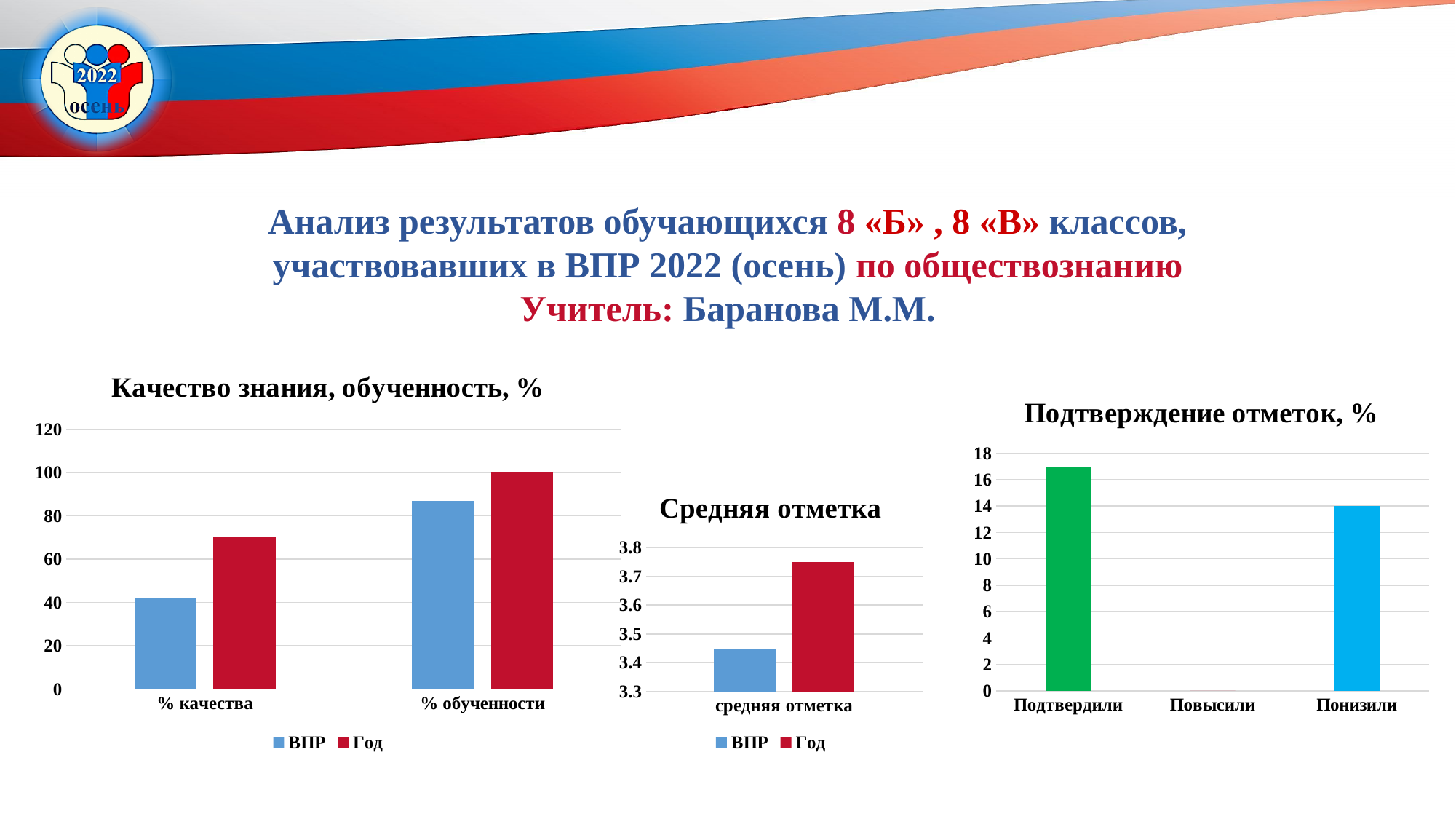
In the chart titled "Средняя отметка", is the value for Год greater or less than 3.7? greater In the chart titled "Качество знания, обученность, %", how many series does the legend list? 2 In the chart titled "Средняя отметка", which series has the larger value, ВПР or Год? Год What kind of chart is the chart titled "Подтверждение отметок, %"? bar chart In the chart titled "Качество знания, обученность, %", is the value for ВПР in the "% обученности" category greater or less than 80? greater In the chart titled "Качество знания, обученность, %", which series has the larger value for "% обученности", ВПР or Год? Год In the chart titled "Качество знания, обученность, %", is the value for ВПР in the "% качества" category greater or less than 60? less In the chart titled "Подтверждение отметок, %", which category has the lowest value? Повысили In the chart titled "Подтверждение отметок, %", which category has the highest value? Подтвердили In the chart titled "Подтверждение отметок, %", how many categories are shown on the x axis? 3